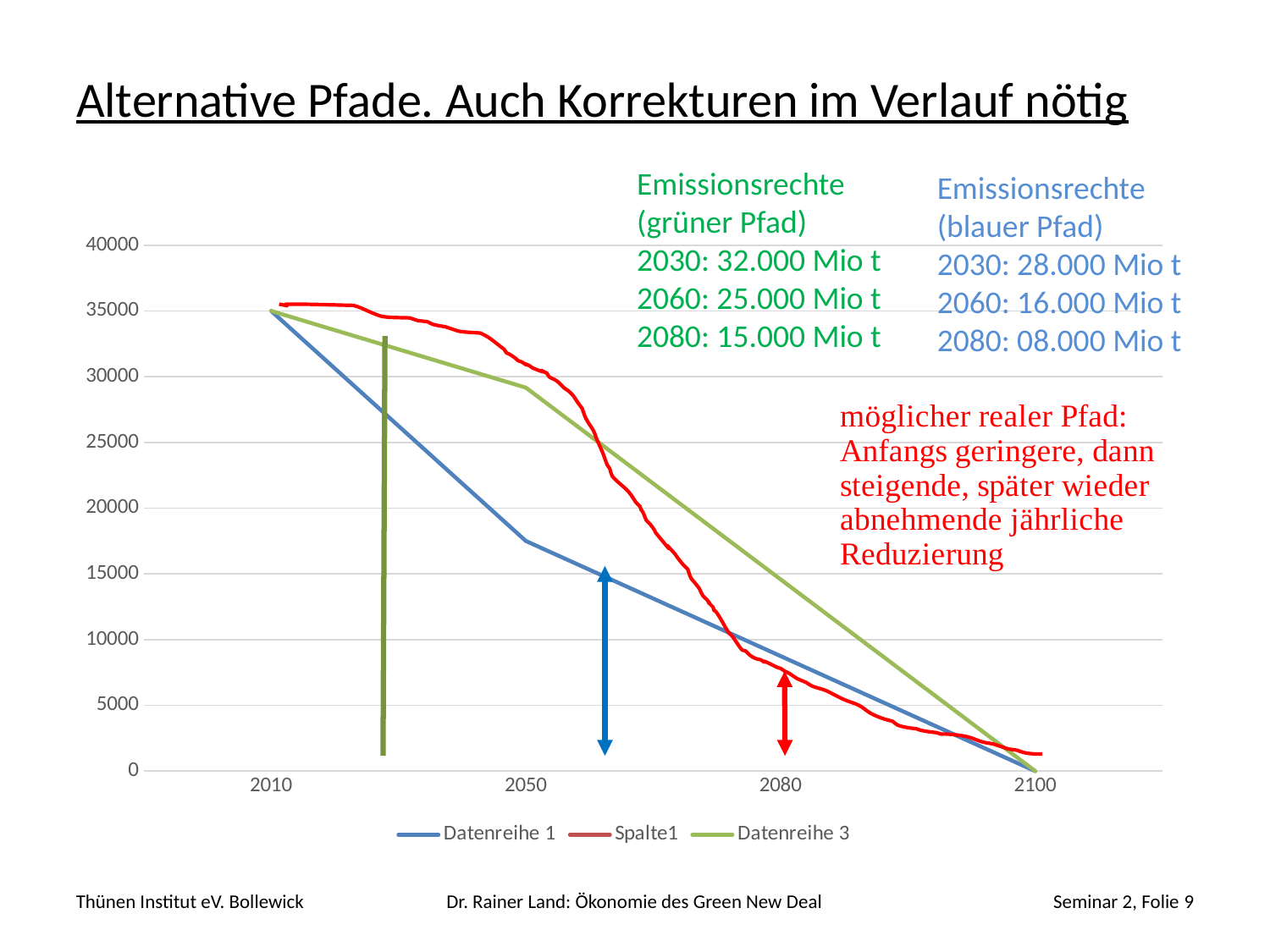
How many series does the chart legend list? 3 At 2050, which series has the higher value, Datenreihe 1 or Datenreihe 3? Datenreihe 3 Is the value of Datenreihe 3 at 2050 greater or less than 25000? greater What are the names of the series listed in the chart legend? Datenreihe 1, Spalte1, Datenreihe 3 Which colour is used for the series Spalte1? red At 2080, which series has the higher value, Spalte1 or Datenreihe 3? Datenreihe 3 Is the value of Datenreihe 1 at 2050 greater or less than 20000? less According to the text on the slide, what are the Emissionsrechte for the green path (grüner Pfad) in 2060? 25.000 Mio t Do the values of Datenreihe 1 rise or fall from 2010 to 2100? fall According to the text on the slide, what are the Emissionsrechte for the blue path (blauer Pfad) in 2080? 08.000 Mio t What kind of chart is shown on the slide? line chart